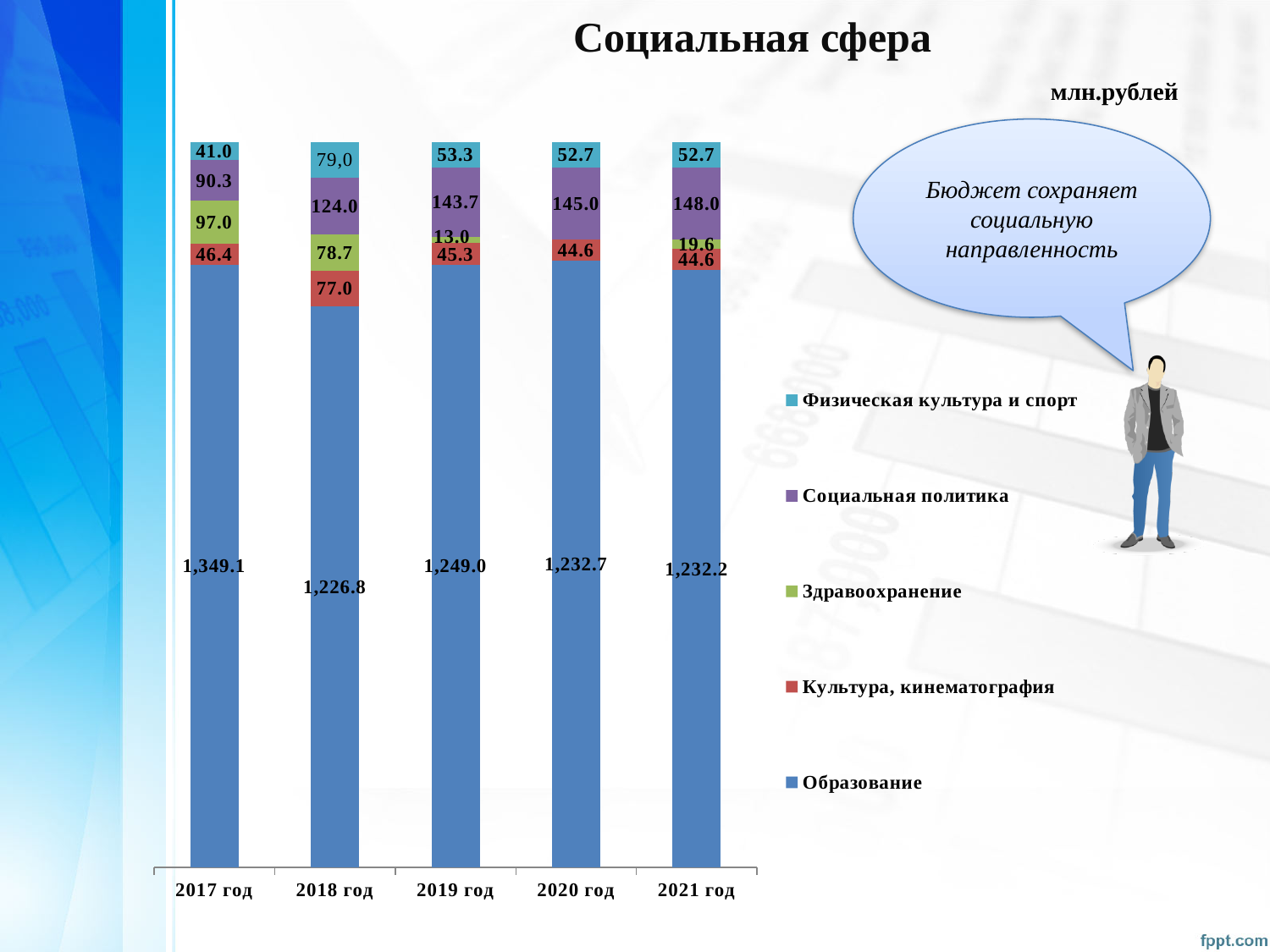
What is the total of the stacked bar for 2017 год? 1,623.8 What unit is stated for the chart values? млн.рублей What kind of chart is shown on the slide? stacked bar chart What is the difference between the Образование values for 2017 год and 2018 год? 122.3 What is the value for Образование in 2017 год? 1,349.1 In which year is the Социальная политика value lowest? 2017 год What is the value for Социальная политика in 2021 год? 148.0 How many years are shown on the x axis? 5 What is the value for Здравоохранение in 2019 год? 13.0 In which year is the Образование value highest? 2017 год Which is larger: Культура, кинематография in 2018 год or in 2019 год? 2018 год How many series does the legend list? 5